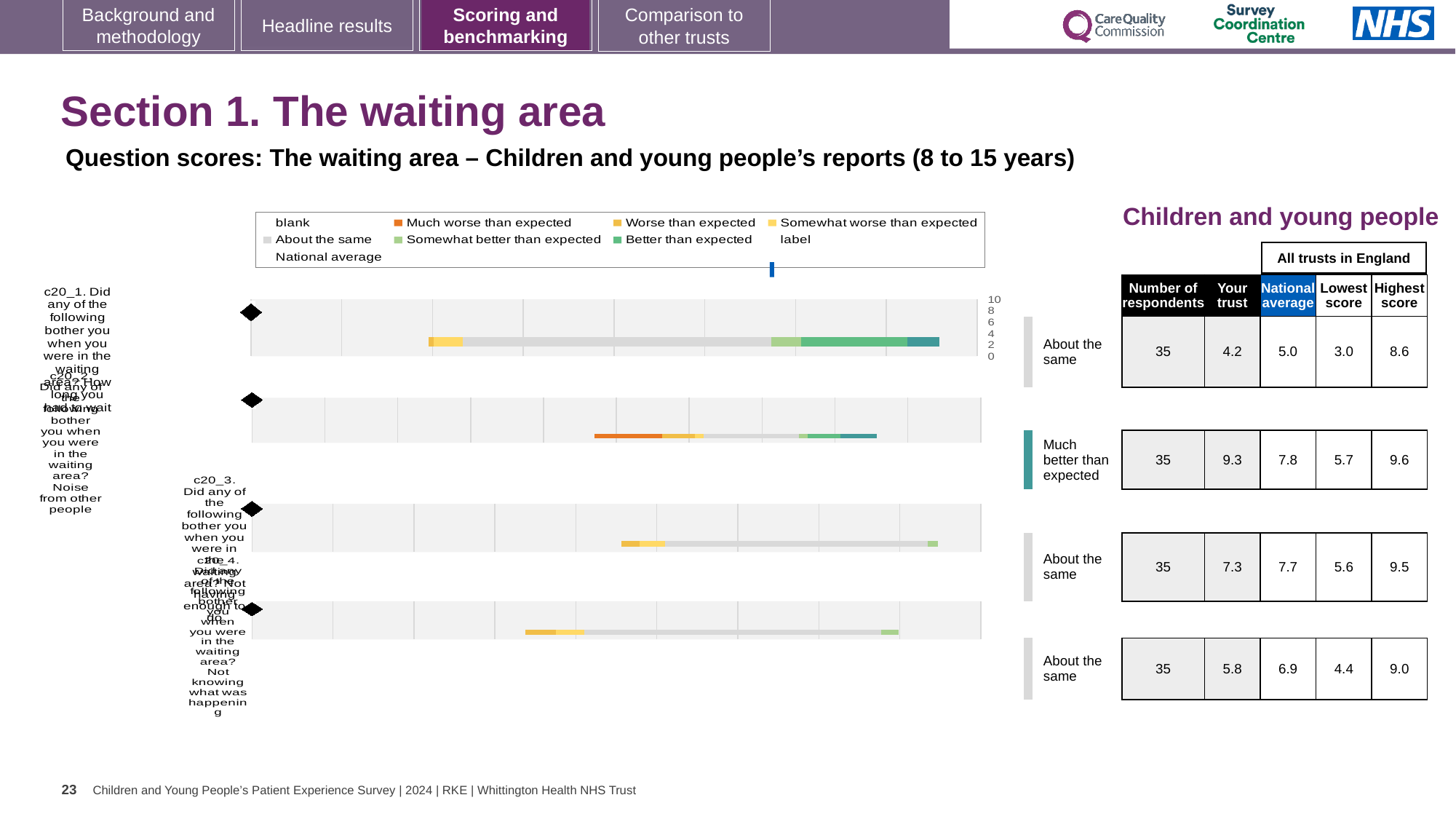
In the table beside the chart, which row has the lowest 'Your trust' score? the first row (c20_1), 4.2 In the table beside the chart, for the first row (c20_1), which is larger: 'Your trust' or 'National average'? National average In the table beside the chart, what is the 'Your trust' score for the second row (c20_2)? 9.3 In the table beside the chart, what is the difference between 'Your trust' and 'National average' for the second row (c20_2)? 1.5 What colour represents 'Much worse than expected' in the chart legend? orange What kind of chart is shown on the left of the slide? bar chart In the table beside the chart, which row has the highest 'Your trust' score? the second row (c20_2), 9.3 How many bars (question rows) does the chart contain? 4 How many entries does the chart legend list? 9 What benchmark label is shown next to the second bar (c20_2) of the chart? Much better than expected In the table beside the chart, how many respondents are listed for each question row? 35 In the table beside the chart, what is the 'Highest score' for the fourth row (c20_4)? 9.0